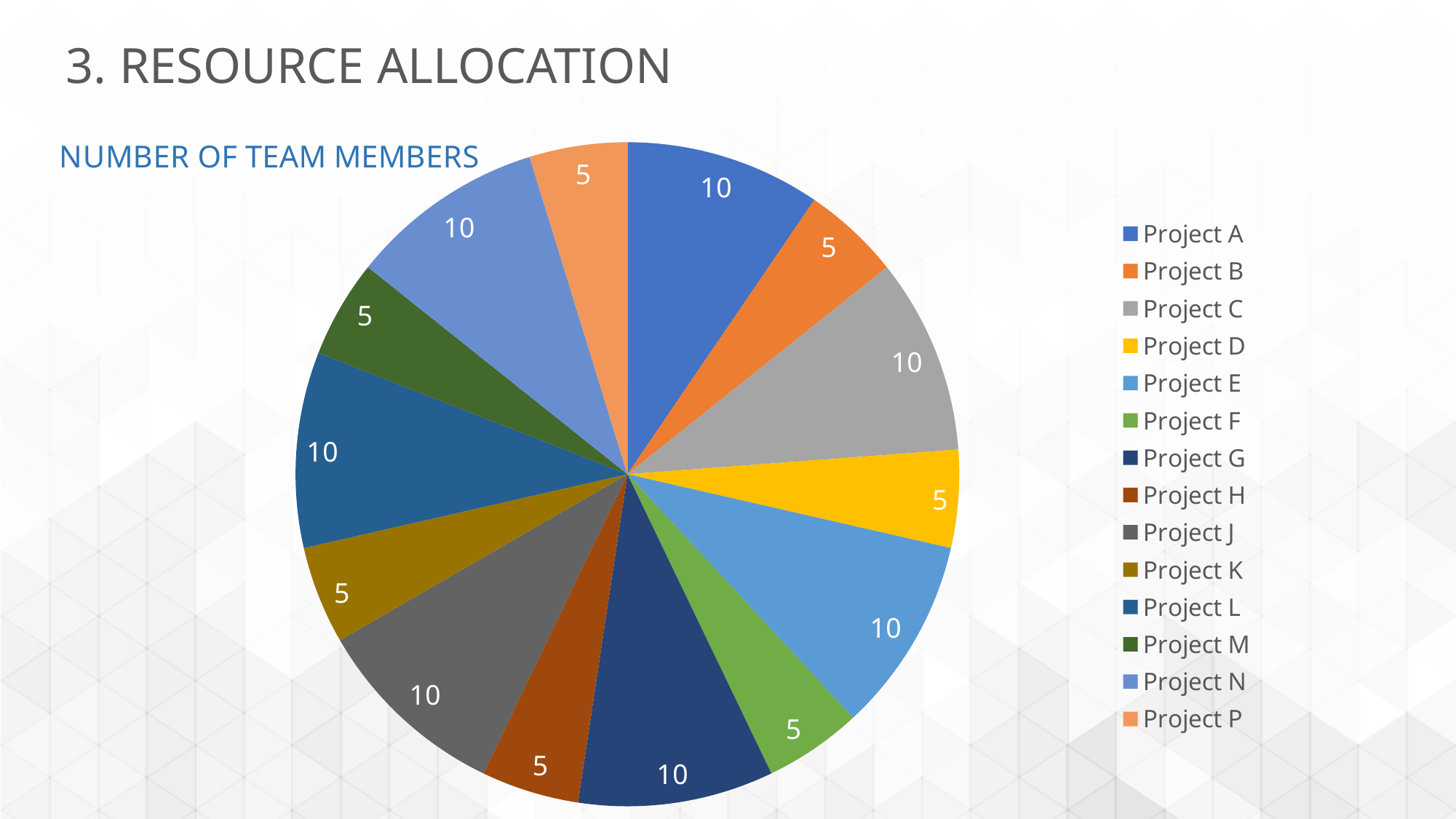
What kind of chart is shown on the slide? pie chart Which has more team members, Project G or Project H? Project G What is the number of team members for Project A? 10 What is the title of the pie chart? NUMBER OF TEAM MEMBERS Which has more team members, Project A or Project B? Project A What is the number of team members for Project J? 10 What is the number of team members for Project P? 5 How many slices does the pie chart have? 14 What is the number of team members for Project B? 5 What is the number of team members for Project L? 10 What is the difference in team members between Project C and Project D? 5 What is the number of team members for Project D? 5